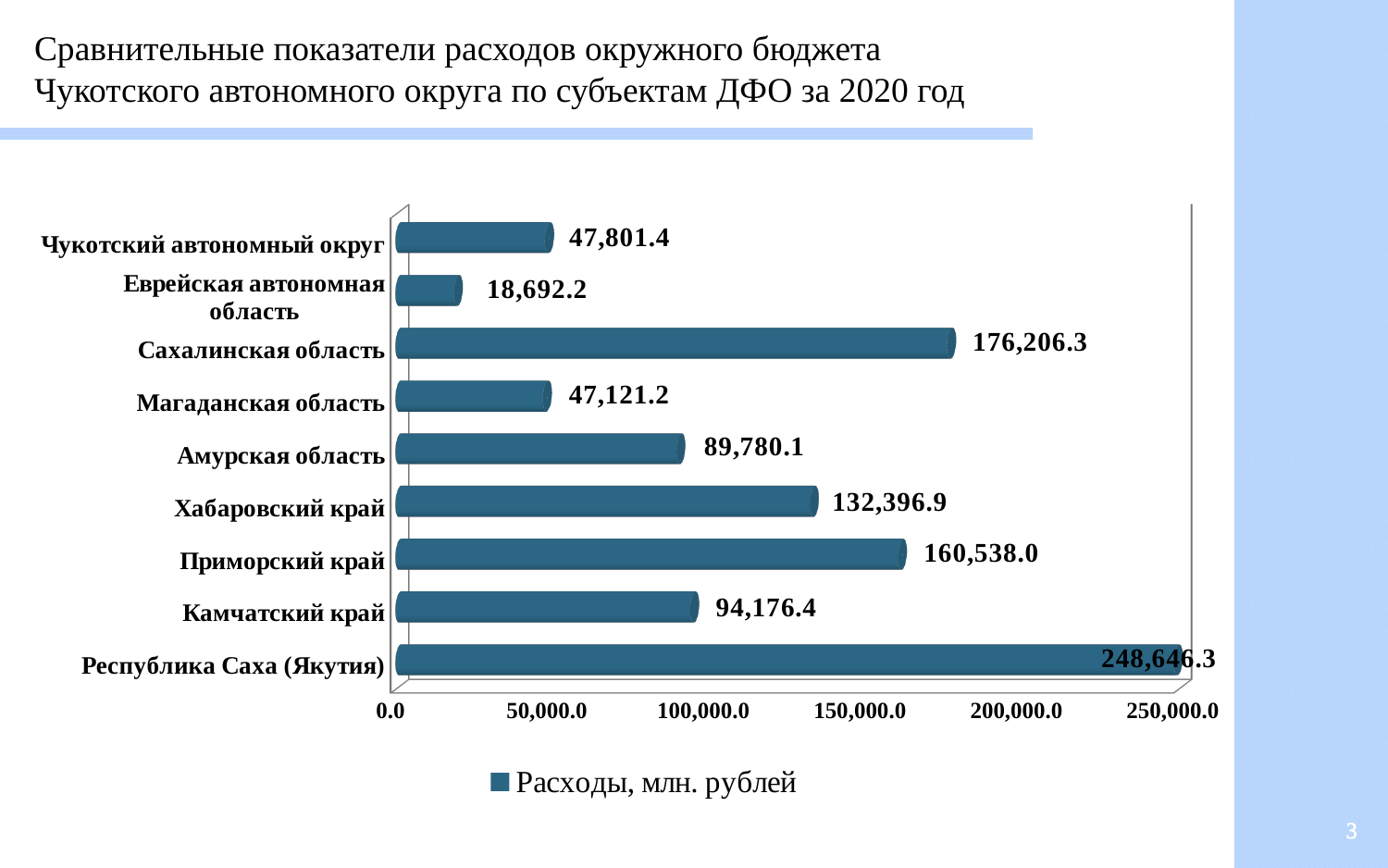
What is the legend entry of the series shown in the chart? Расходы, млн. рублей What is the difference between the values for Чукотский автономный округ and Магаданская область? 680.2 What is the value for Камчатский край? 94,176.4 What is the difference between the values for Сахалинская область and Приморский край? 15,668.3 What type of chart is shown on the slide? Bar chart How many regions are shown in the chart? 9 Which region has the highest value? Республика Саха (Якутия) Which region has the lowest value? Еврейская автономная область Which is larger, the value for Хабаровский край or the value for Амурская область? Хабаровский край What is the value for Сахалинская область? 176,206.3 How many series does the legend list? 1 What is the value for Чукотский автономный округ? 47,801.4